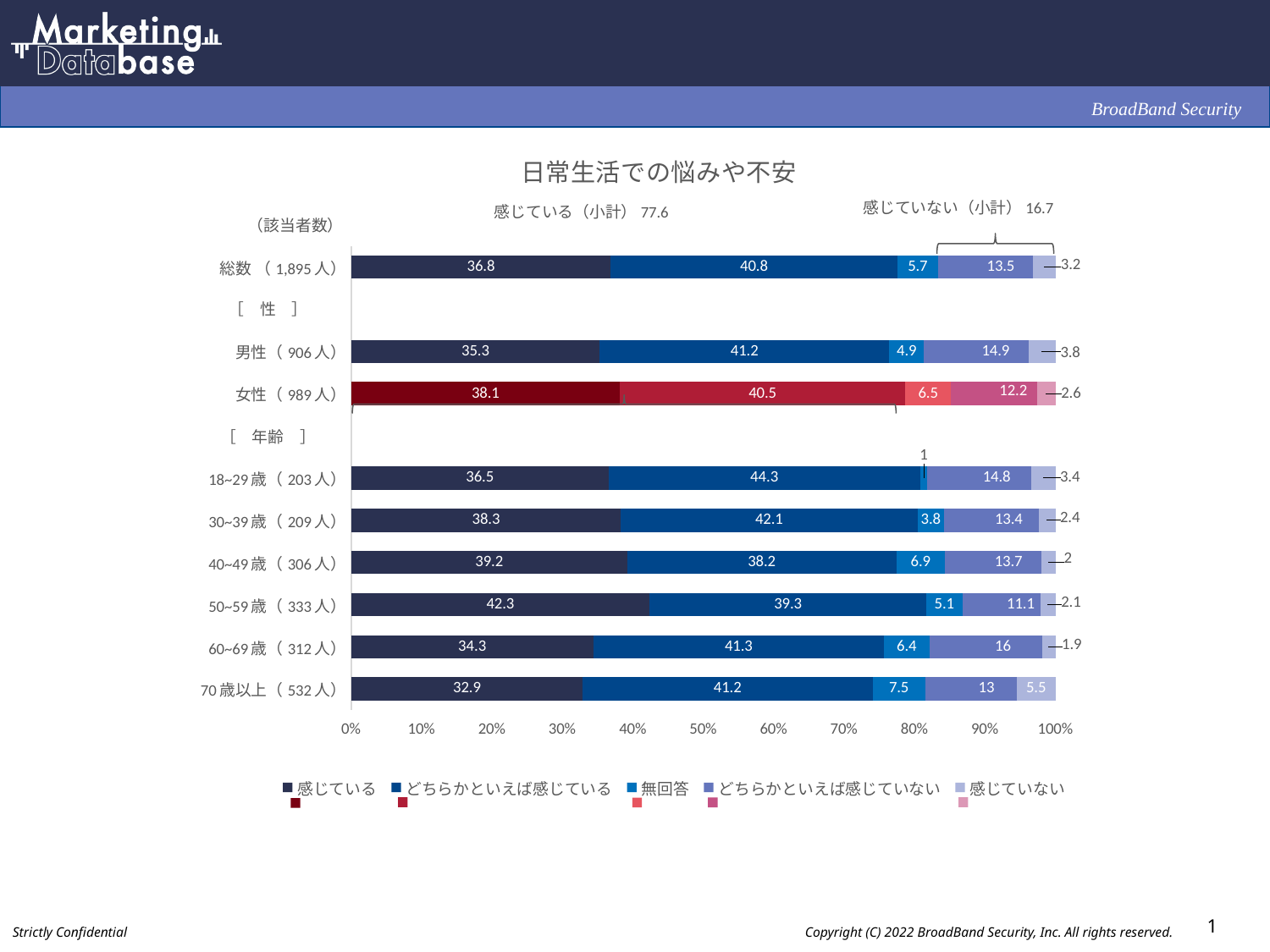
What is the title of the chart? 日常生活での悩みや不安 What is the value of 感じている for 総数 (1,895人)? 36.8 How many series does the legend list? 5 What is the difference between the 感じている values for 女性 (989人) and 男性 (906人)? 2.8 What kind of chart is shown on the slide? Stacked bar chart Which category has the lowest value for 感じている? 70歳以上 (532人) What is the value of どちらかといえば感じている for 18~29歳 (203人)? 44.3 What is the value of どちらかといえば感じていない for 60~69歳 (312人)? 16 Which is larger, the 感じていない value for 70歳以上 (532人) or for 60~69歳 (312人)? 70歳以上 (532人) What is the value of 無回答 for 70歳以上 (532人)? 7.5 How many categories (bars) are plotted in the chart? 9 Which category has the highest value for 感じている? 50~59歳 (333人)